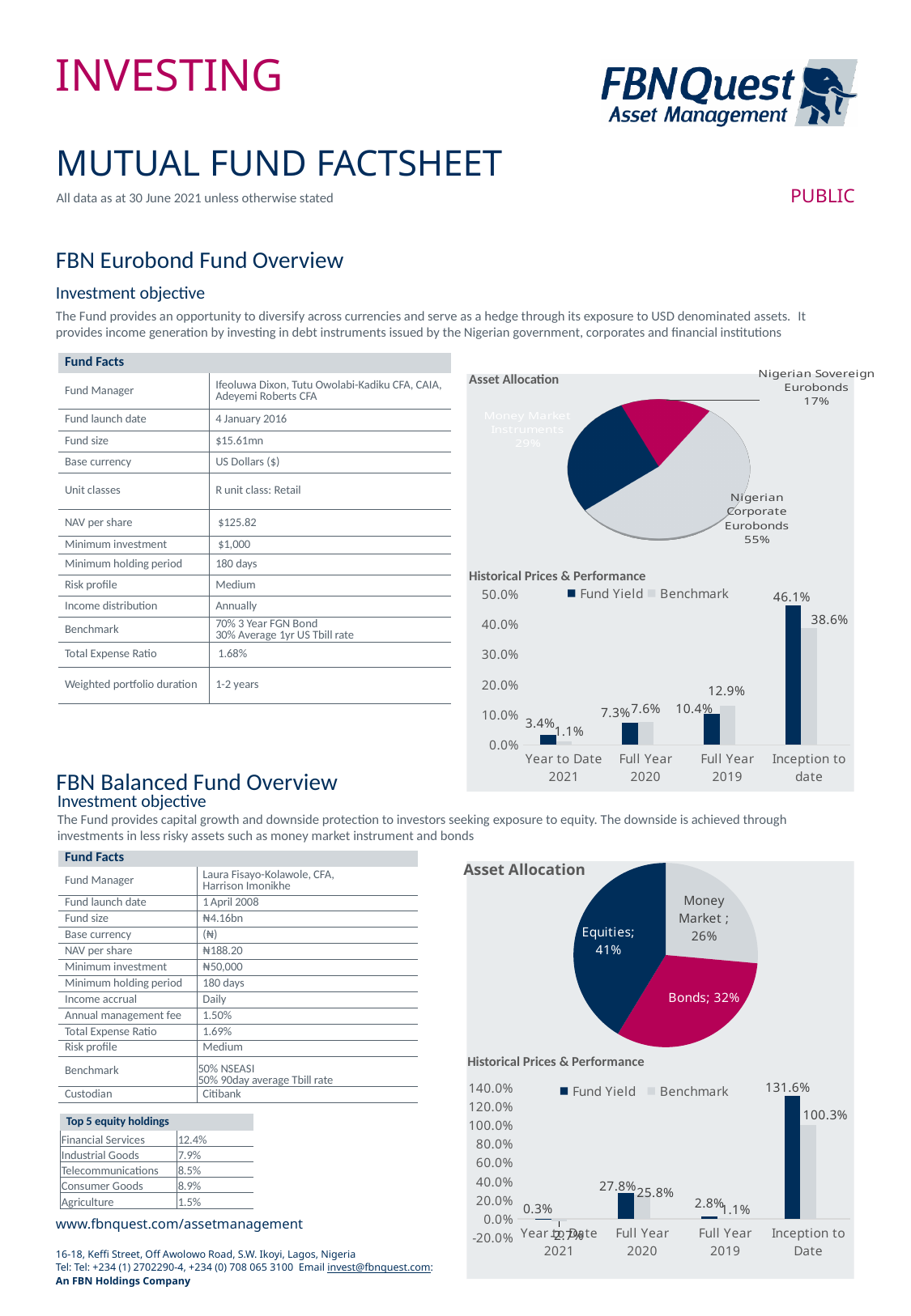
In the FBN Eurobond Fund Historical Prices & Performance chart, what is the Fund Yield for Inception to date? 46.1% How many series does the legend list in the FBN Eurobond Fund Historical Prices & Performance chart? 2 In the FBN Balanced Fund Asset Allocation pie chart, which category has the largest share? Equities In the FBN Balanced Fund Historical Prices & Performance chart, what is the Fund Yield for Full Year 2020? 27.8% In the FBN Eurobond Fund Historical Prices & Performance chart, what is the difference between the Fund Yield and Benchmark for Inception to date? 7.5% In the FBN Eurobond Fund Asset Allocation pie chart, which category has the smallest share? Nigerian Sovereign Eurobonds In the FBN Eurobond Fund Historical Prices & Performance chart, what is the Benchmark value for Full Year 2019? 12.9% In the FBN Balanced Fund Asset Allocation pie chart, what share is Bonds? 32% In the FBN Eurobond Fund Historical Prices & Performance chart, which is larger for Full Year 2020, Fund Yield or Benchmark? Benchmark What type of chart is the FBN Balanced Fund Historical Prices & Performance chart? Bar chart In the FBN Eurobond Fund Asset Allocation pie chart, what share is Nigerian Corporate Eurobonds? 55% In the FBN Balanced Fund Historical Prices & Performance chart, what is the Fund Yield for Inception to Date? 131.6%